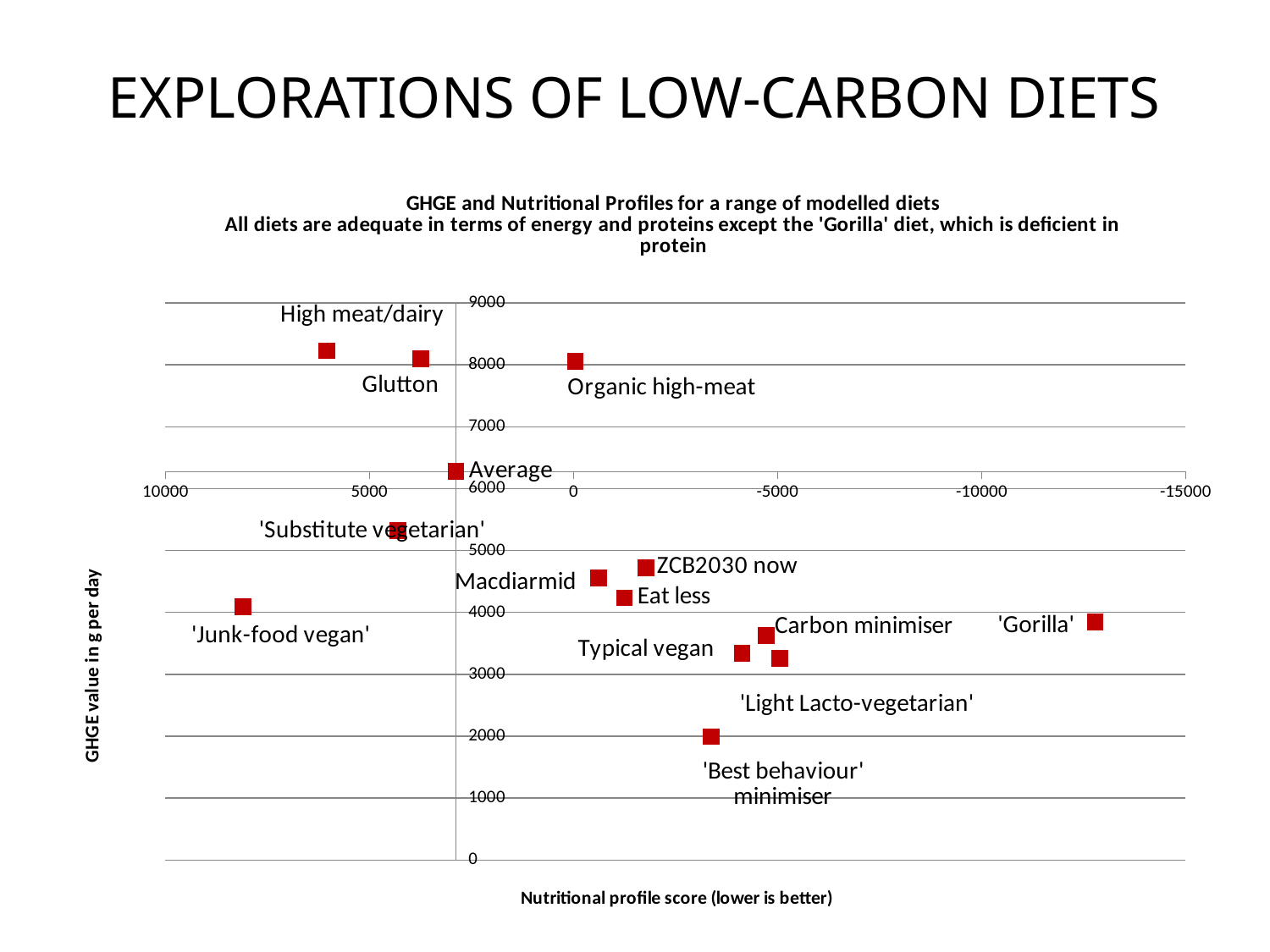
What is the title of the vertical axis? GHGE value in g per day Is the GHGE value for High meat/dairy greater or less than 8000? greater Which diet has the highest GHGE value? High meat/dairy Which diet has the highest (worst) nutritional profile score, i.e. is furthest to the left on the x axis? 'Junk-food vegan' Which diet has the lowest GHGE value? 'Best behaviour' minimiser Is the nutritional profile score for 'Gorilla' greater or less than -10000? less What kind of chart is shown on the slide? Scatter chart Which diet has the lowest (best) nutritional profile score, i.e. is furthest to the right on the x axis? 'Gorilla' Is the GHGE value for 'Best behaviour' minimiser greater or less than 3000? less How many diets are plotted as points on the chart? 14 Which diet has a higher GHGE value, Glutton or 'Best behaviour' minimiser? Glutton